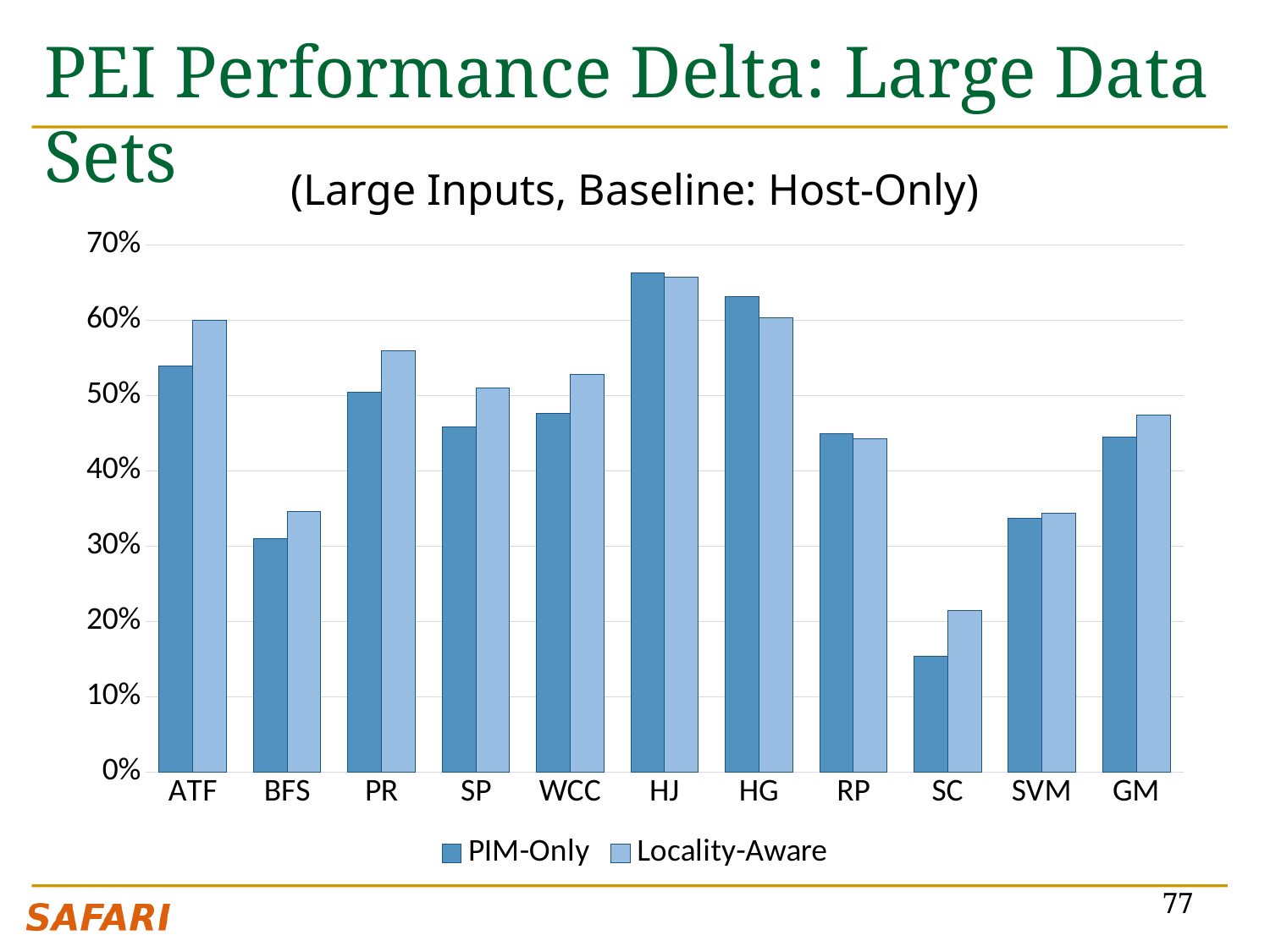
Which category has the lowest PIM-Only value? SC For HG, which series has the larger value, PIM-Only or Locality-Aware? PIM-Only Is the PIM-Only value for ATF greater or less than 50%? greater Is the Locality-Aware value for BFS greater or less than 30%? greater For ATF, which series has the larger value, PIM-Only or Locality-Aware? Locality-Aware Which category has the highest PIM-Only value? HJ What is the subtitle shown above the chart? (Large Inputs, Baseline: Host-Only) Which category has the lowest Locality-Aware value? SC How many series does the chart's legend list? 2 How many categories are shown on the x axis of the chart? 11 What kind of chart is shown on the slide? bar chart Is the PIM-Only value for SC greater or less than 20%? less